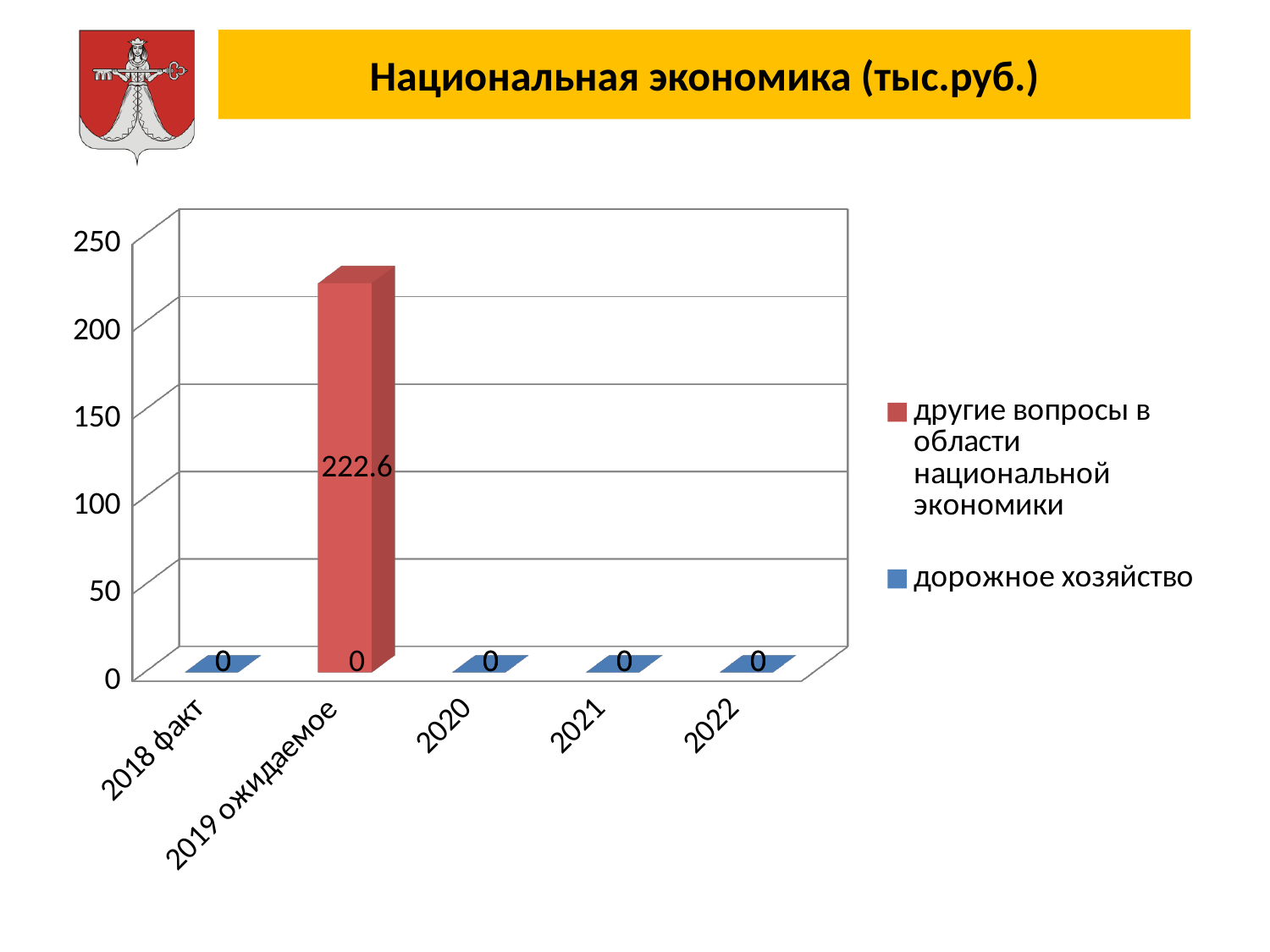
Which is larger in 2019 ожидаемое: 'другие вопросы в области национальной экономики' or 'дорожное хозяйство'? другие вопросы в области национальной экономики Is the value for 'другие вопросы в области национальной экономики' in 2019 ожидаемое greater or less than 200? greater What is the title of the chart? Национальная экономика (тыс.руб.) What is the difference between 'другие вопросы в области национальной экономики' and 'дорожное хозяйство' in 2019 ожидаемое? 222.6 Which category has the highest value for 'другие вопросы в области национальной экономики'? 2019 ожидаемое How many series does the legend list? 2 How many categories are shown on the x axis? 5 Which colour represents 'дорожное хозяйство' in the legend? blue What kind of chart is shown on the slide? bar chart What is the value for 'другие вопросы в области национальной экономики' in 2019 ожидаемое? 222.6 What is the value for 'дорожное хозяйство' in 2018 факт? 0 What is the value for 'дорожное хозяйство' in 2022? 0